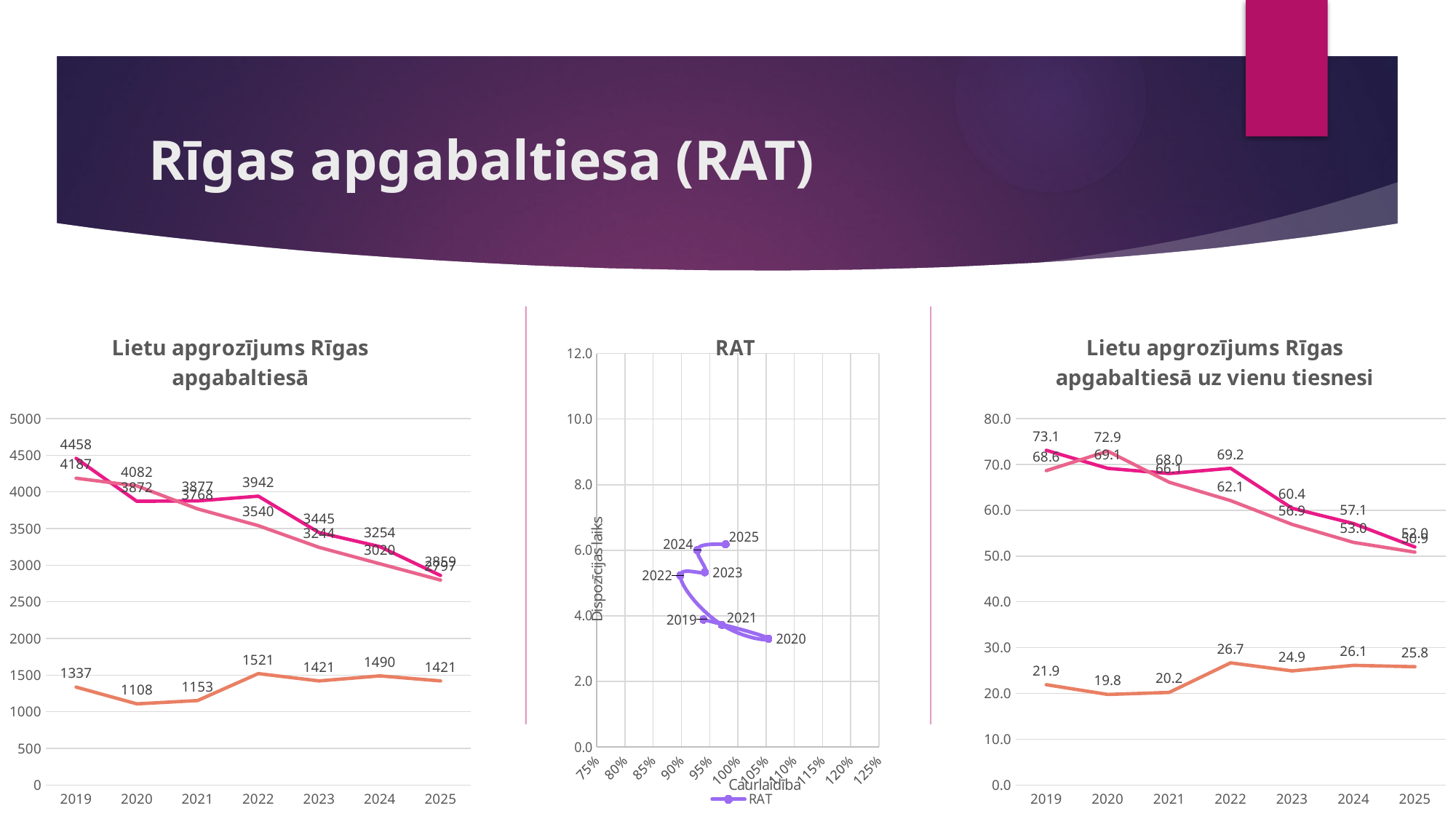
In the chart titled "Lietu apgrozījums Rīgas apgabaltiesā", how many years are shown on the x axis? 7 In the chart titled "RAT", is the Dispozīcijas laiks value for 2020 greater or less than 4.0? less In the chart titled "Lietu apgrozījums Rīgas apgabaltiesā", what is the highest value shown on the top (magenta) line? 4458 In the chart titled "Lietu apgrozījums Rīgas apgabaltiesā", what is the value of the orange line in 2022? 1521 In the chart titled "Lietu apgrozījums Rīgas apgabaltiesā uz vienu tiesnesi", does the top (magenta) line generally rise or fall from 2019 to 2025? fall What kind of chart is the chart titled "Lietu apgrozījums Rīgas apgabaltiesā uz vienu tiesnesi"? line chart In the chart titled "Lietu apgrozījums Rīgas apgabaltiesā uz vienu tiesnesi", which year has the lowest value on the orange line? 2020 In the chart titled "Lietu apgrozījums Rīgas apgabaltiesā", what is the difference between the orange line's values in 2022 and 2020? 413 In the chart titled "RAT", what is the label of the x axis? Caurlaidība In the chart titled "Lietu apgrozījums Rīgas apgabaltiesā uz vienu tiesnesi", is the orange line's value in 2024 larger or smaller than its value in 2023? larger In the chart titled "Lietu apgrozījums Rīgas apgabaltiesā uz vienu tiesnesi", what is the value of the orange line in 2022? 26.7 In the chart titled "Lietu apgrozījums Rīgas apgabaltiesā", in which year is the orange line at its lowest? 2020